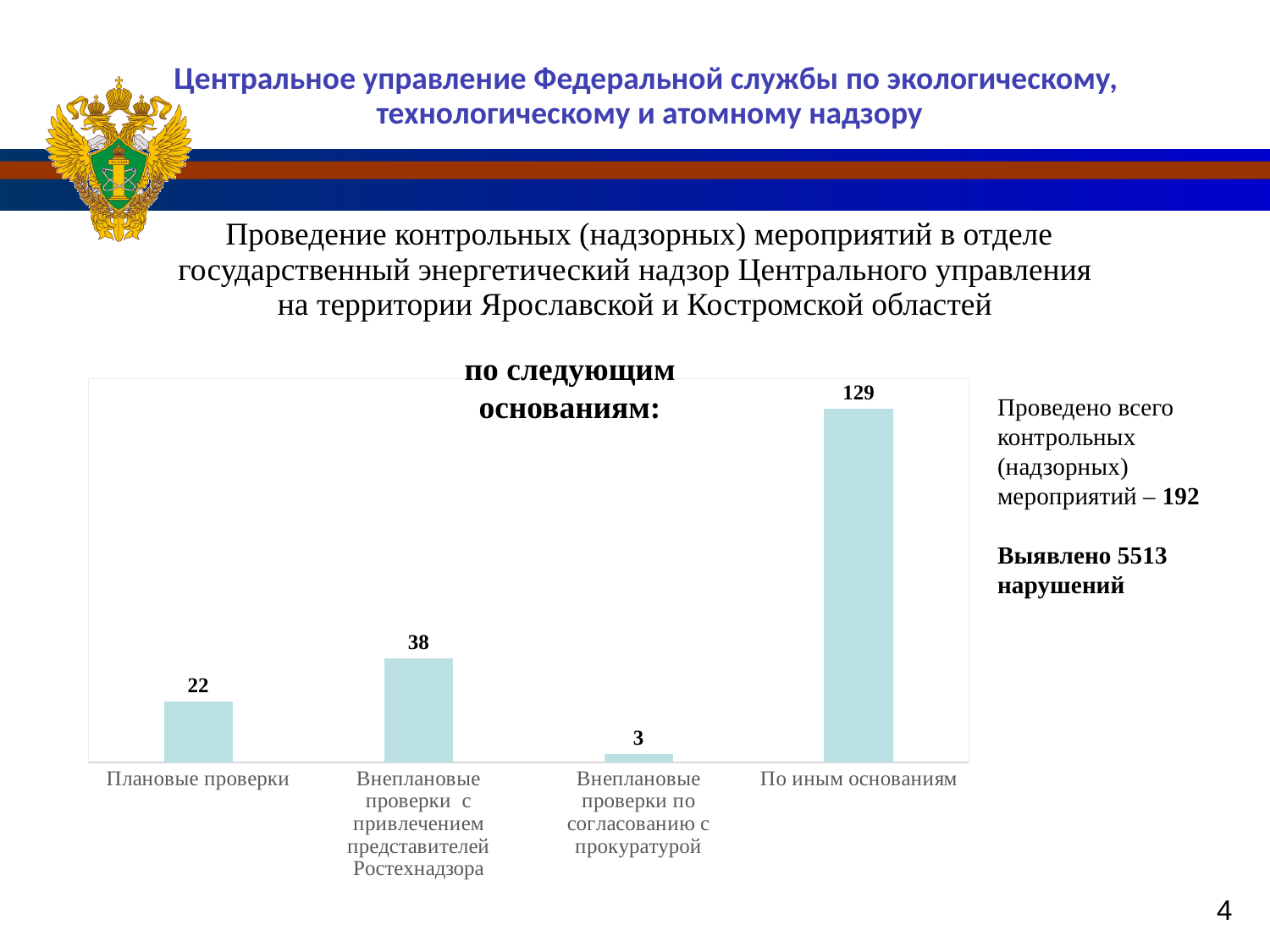
Which category has the lowest value? Внеплановые проверки по согласованию с прокуратурой What is the value for По иным основаниям? 129 What is the title of the chart? по следующим основаниям: What kind of chart is shown on the slide? bar chart What is the value for Плановые проверки? 22 What is the difference between the values for По иным основаниям and Плановые проверки? 107 What is the value for Внеплановые проверки по согласованию с прокуратурой? 3 What is the value for Внеплановые проверки с привлечением представителей Ростехнадзора? 38 How many categories are shown in the chart? 4 Which category has the highest value? По иным основаниям Which is larger: the value for Плановые проверки or the value for Внеплановые проверки с привлечением представителей Ростехнадзора? Внеплановые проверки с привлечением представителей Ростехнадзора What is the difference between the values for Внеплановые проверки с привлечением представителей Ростехнадзора and Плановые проверки? 16